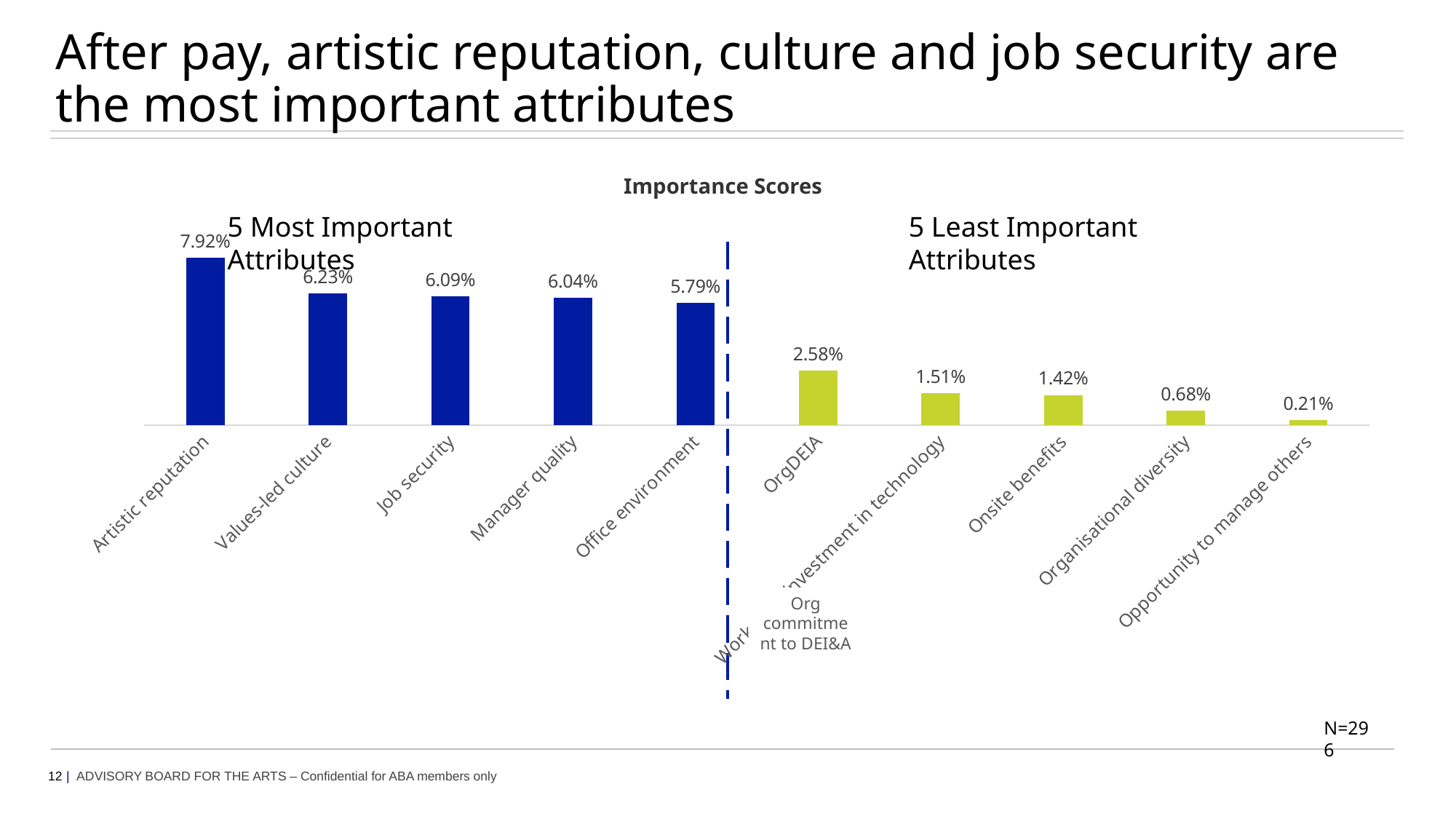
What is the importance score for Artistic reputation? 7.92% Which attribute has the lowest importance score? Opportunity to manage others What is the difference between the importance scores for Artistic reputation and Values-led culture? 1.69% What type of chart is shown on the slide? Bar chart Do the importance scores rise or fall from left to right across the chart? Fall How many attributes are plotted in the chart? 10 Which attribute has the highest importance score? Artistic reputation What is the importance score for Opportunity to manage others? 0.21% What is the title of the chart? Importance Scores What is the importance score for Onsite benefits? 1.42% What is the importance score for Job security? 6.09% Which has a higher importance score, Office environment or OrgDEIA? Office environment